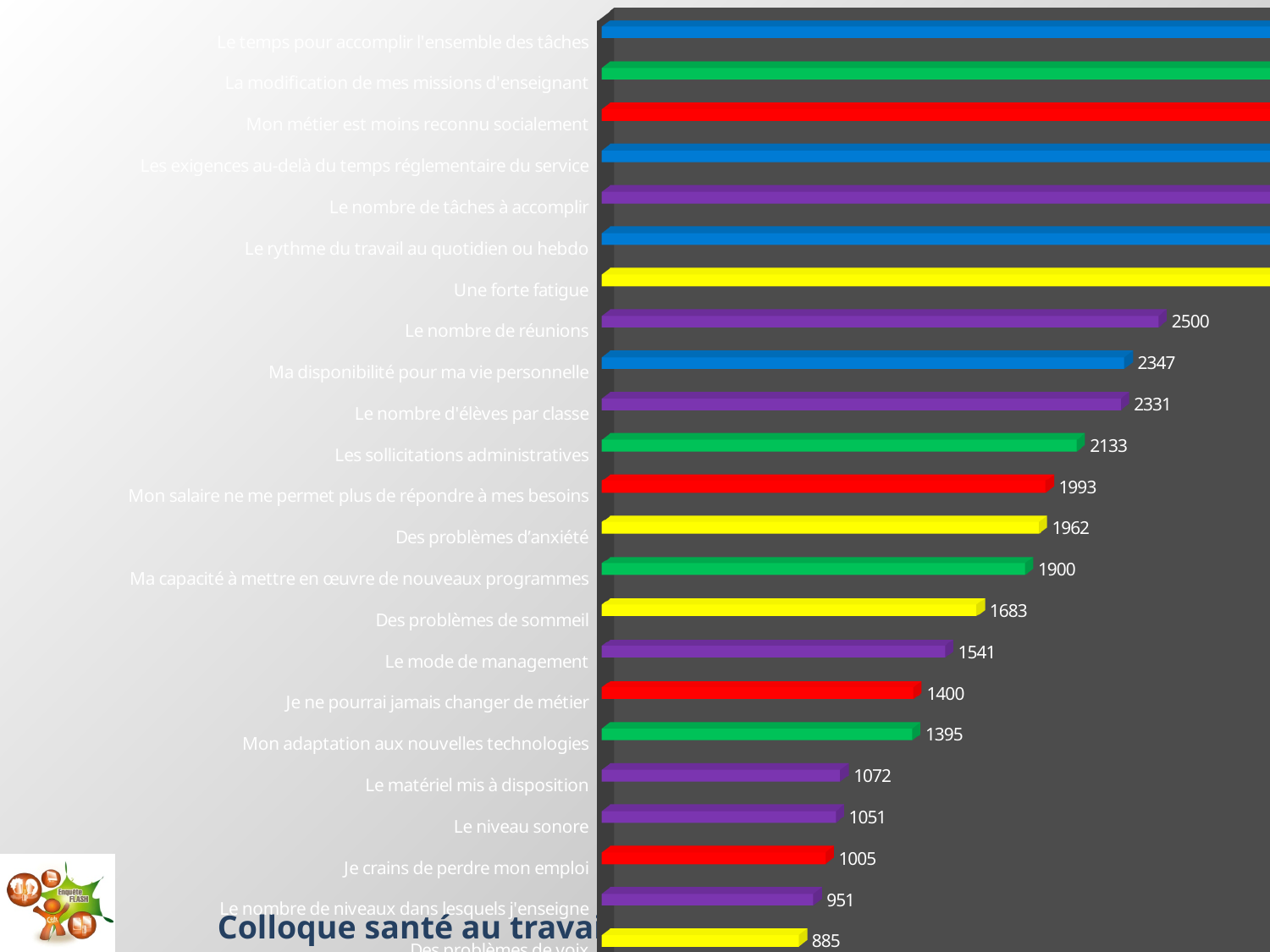
What is the value for "Ma disponibilité pour ma vie personnelle"? 2347 What is the value for "Le mode de management"? 1541 What is the difference between the values for "Le nombre de réunions" and "Les sollicitations administratives"? 367 What kind of chart is shown on the slide? bar chart Which has the larger value, "Le matériel mis à disposition" or "Mon adaptation aux nouvelles technologies"? Mon adaptation aux nouvelles technologies What is the value for "Le niveau sonore"? 1051 What is the value for "Le nombre de réunions"? 2500 Which has the larger value, "Le nombre d'élèves par classe" or "Mon salaire ne me permet plus de répondre à mes besoins"? Le nombre d'élèves par classe What is the difference between the values for "Des problèmes de sommeil" and "Je ne pourrai jamais changer de métier"? 283 What is the value for "Je crains de perdre mon emploi"? 1005 What is the value for "Des problèmes d'anxiété"? 1962